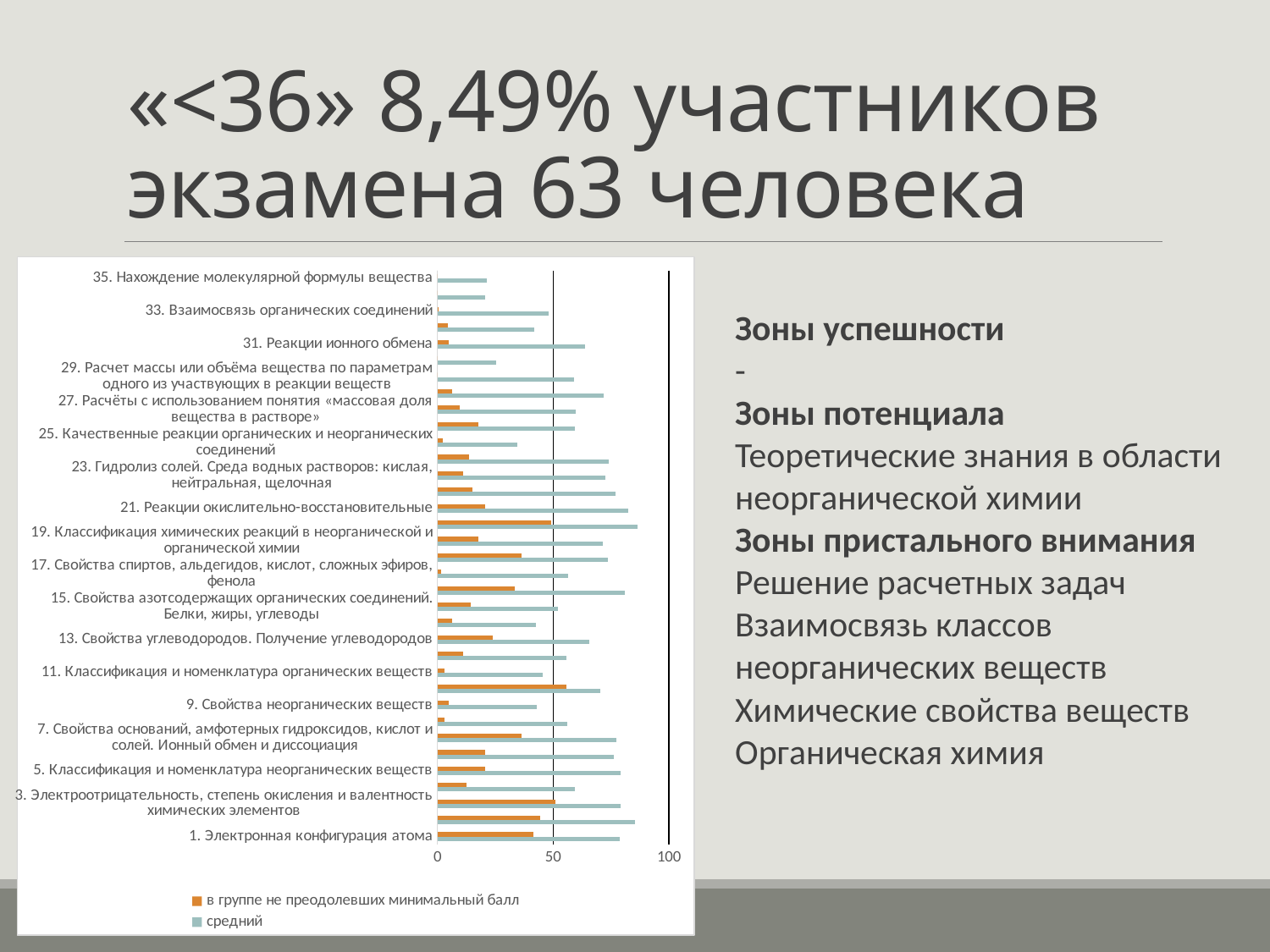
What kind of chart is shown on the slide? bar chart Is the 'в группе не преодолевших минимальный балл' value for '9. Свойства неорганических веществ' greater or less than 50? less Is the 'средний' value for '35. Нахождение молекулярной формулы вещества' greater or less than 50? less Which has the larger 'средний' value: '1. Электронная конфигурация атома' or '35. Нахождение молекулярной формулы вещества'? 1. Электронная конфигурация атома What are the two series named in the chart legend? в группе не преодолевших минимальный балл; средний Which series is drawn in orange in the chart? в группе не преодолевших минимальный балл Is the 'средний' value for '1. Электронная конфигурация атома' greater or less than 50? greater How many series does the chart legend list? 2 Which has the larger 'в группе не преодолевших минимальный балл' value: '3. Электроотрицательность, степень окисления и валентность химических элементов' or '9. Свойства неорганических веществ'? 3. Электроотрицательность, степень окисления и валентность химических элементов For '1. Электронная конфигурация атома', which series has the larger value: 'средний' or 'в группе не преодолевших минимальный балл'? средний